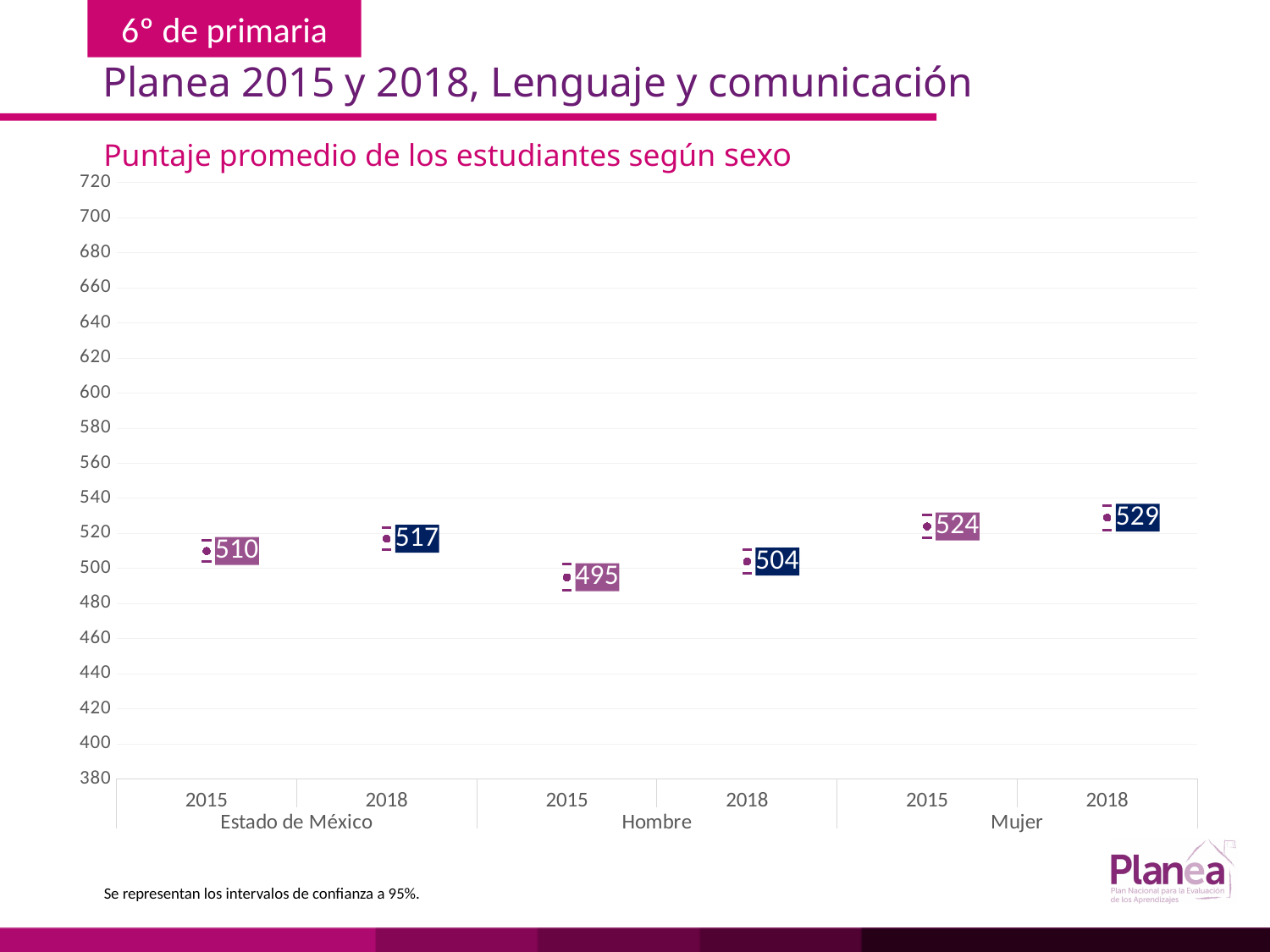
How many data points are plotted on the chart? 6 Which group and year has the highest average score? Mujer 2018 Is the Hombre 2015 average score greater or less than 500? less By how many points did the Estado de México average score change from 2015 to 2018? 7 What is the average score for Hombre in 2015? 495 What is the average score for Estado de México in 2015? 510 Which group and year has the lowest average score? Hombre 2015 What is the average score for Hombre in 2018? 504 What is the average score for Mujer in 2018? 529 What is the difference between the Mujer and Hombre average scores in 2018? 25 Which is larger, the Mujer score in 2015 or the Estado de México score in 2018? Mujer 2015 What is the subtitle of the chart? Puntaje promedio de los estudiantes según sexo